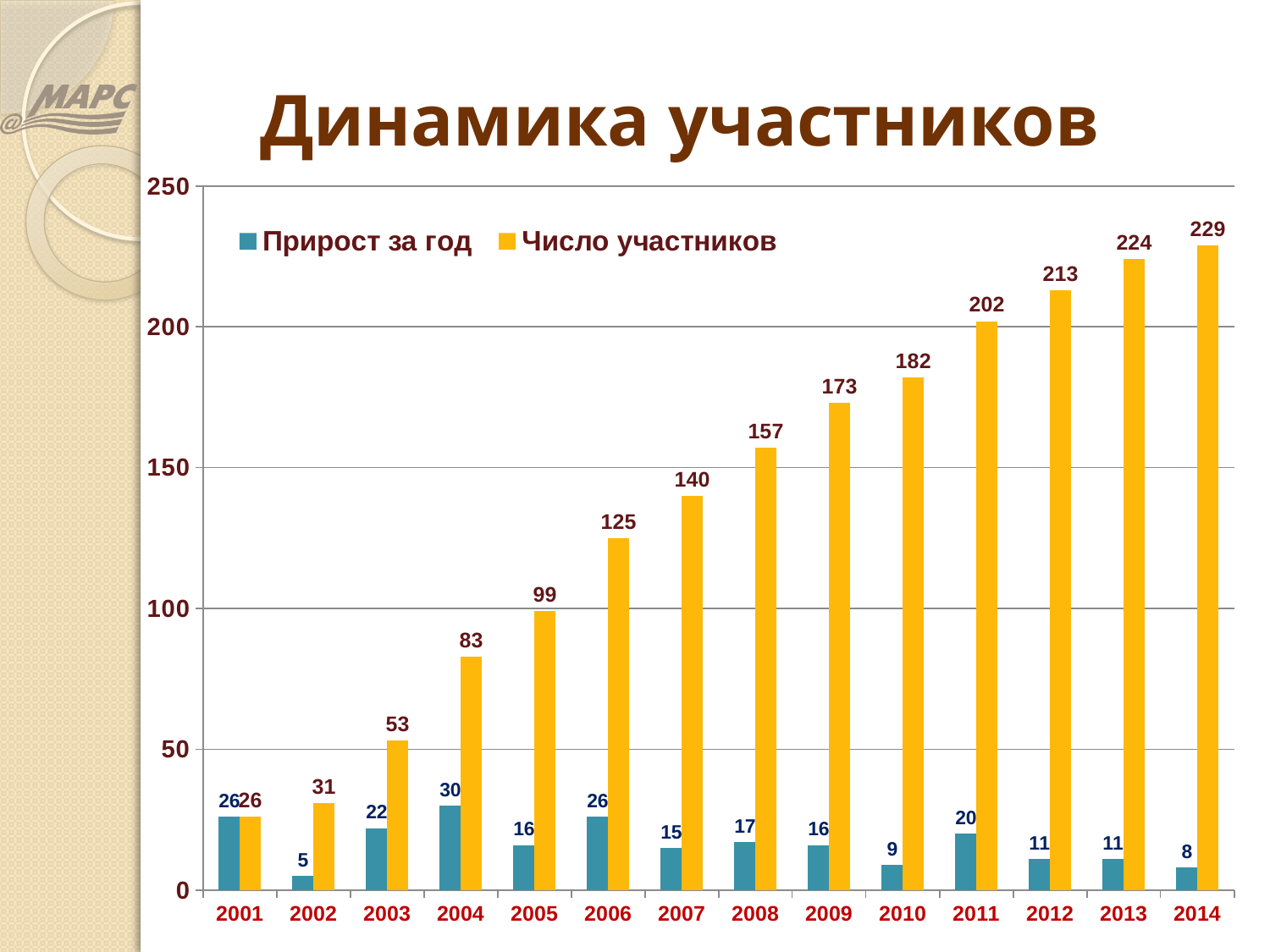
What is the value of "Число участников" for 2008? 157 Which is larger: "Прирост за год" in 2011 or in 2010? 2011 In which year is "Прирост за год" lowest? 2002 In which year is "Число участников" highest? 2014 Does "Число участников" rise or fall from 2001 to 2014? rise What is the value of "Прирост за год" for 2004? 30 What kind of chart is shown on the slide? bar chart What is the value of "Число участников" for 2014? 229 What is the difference between "Число участников" in 2013 and 2012? 11 How many years are shown on the x axis? 14 Is the value of "Число участников" for 2009 greater or less than 150? greater How many series does the legend list? 2